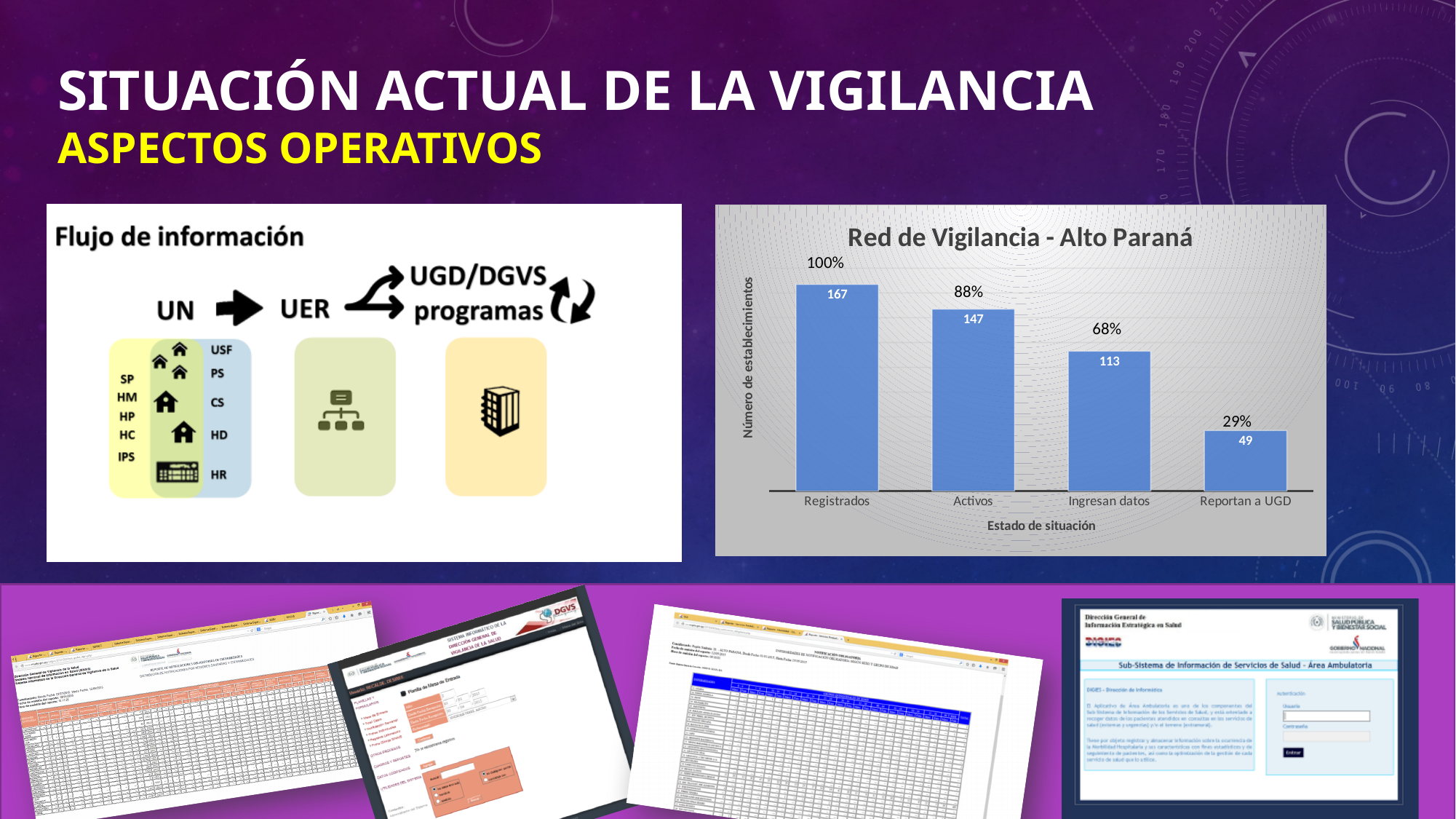
What type of chart is 'Red de Vigilancia - Alto Paraná'? bar chart What is the number of establishments for 'Activos' in the 'Red de Vigilancia - Alto Paraná' chart? 147 What is the title of the bar chart on the slide? Red de Vigilancia - Alto Paraná What is the label of the x axis in the 'Red de Vigilancia - Alto Paraná' chart? Estado de situación What is the difference between the 'Registrados' and 'Activos' values in the 'Red de Vigilancia - Alto Paraná' chart? 20 What percentage is shown above the 'Ingresan datos' bar in the 'Red de Vigilancia - Alto Paraná' chart? 68% What is the value for 'Reportan a UGD' in the 'Red de Vigilancia - Alto Paraná' chart? 49 How many categories are shown on the x axis of the 'Red de Vigilancia - Alto Paraná' chart? 4 Which category has the lowest value in the 'Red de Vigilancia - Alto Paraná' chart? Reportan a UGD What is the number of establishments for 'Registrados' in the 'Red de Vigilancia - Alto Paraná' chart? 167 Which category has the highest value in the 'Red de Vigilancia - Alto Paraná' chart? Registrados Do the values rise or fall from left to right along the x axis in the 'Red de Vigilancia - Alto Paraná' chart? fall